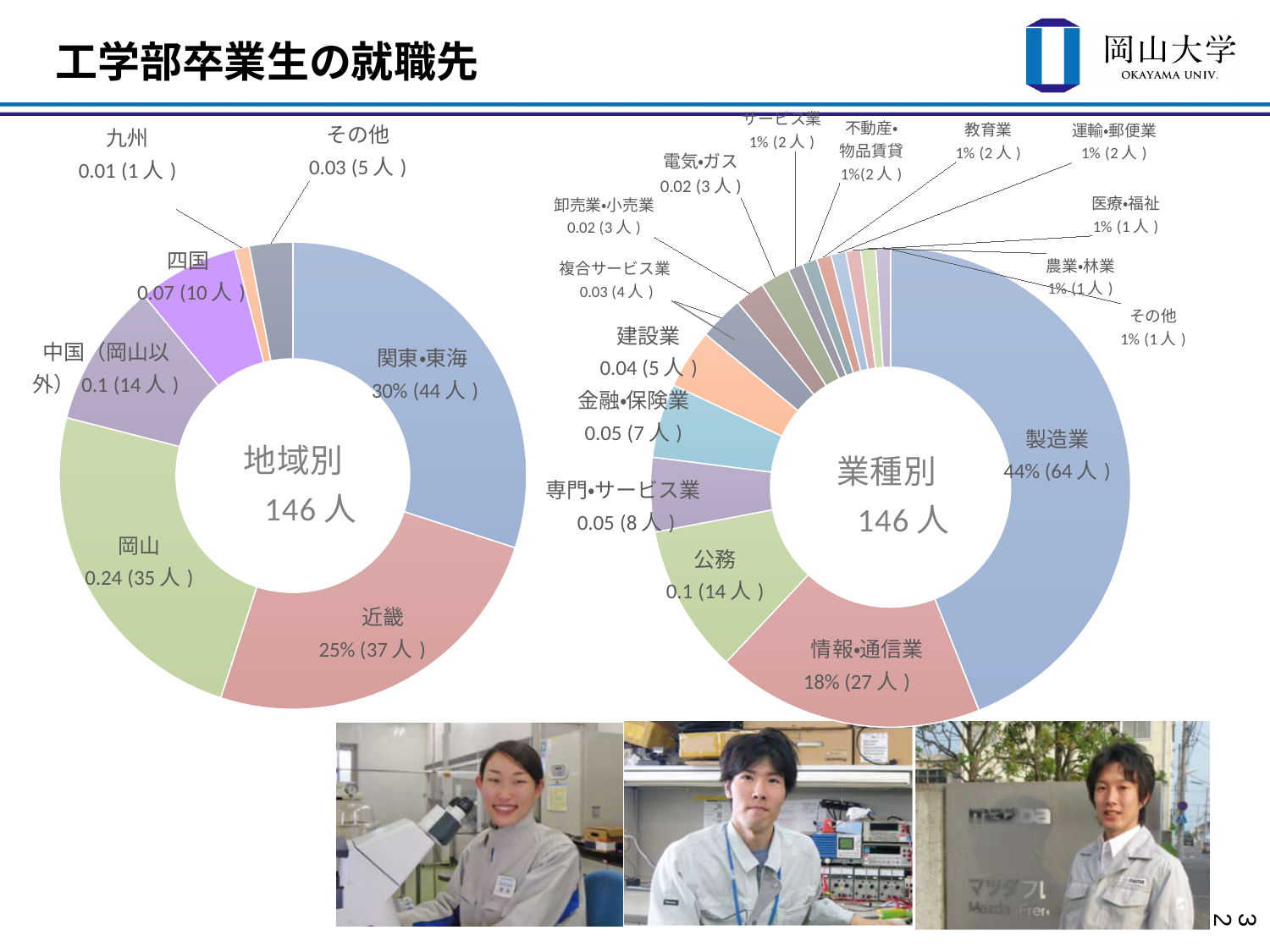
In the 地域別 chart, what is the value shown for 岡山? 0.24 (35人) In the 地域別 chart, which region has the smallest share? 九州 What total number of people is shown in the centre of each donut chart? 146人 How many categories does the 地域別 chart show? 7 In the 業種別 chart, which is larger, 公務 or 建設業? 公務 In the 業種別 chart, what is the value shown for 情報•通信業? 18% (27人) In the 業種別 chart, how many more people are in 製造業 than in 情報•通信業? 37人 In the 地域別 chart, which region has the largest share? 関東•東海 In the 地域別 chart, how many more people went to 近畿 than to 四国? 27人 In the 地域別 chart, what is the value shown for 関東•東海? 30% (44人) In the 業種別 chart, what is the value shown for 製造業? 44% (64人) What kind of chart is the 地域別 chart on the left of the slide? Pie (donut) chart